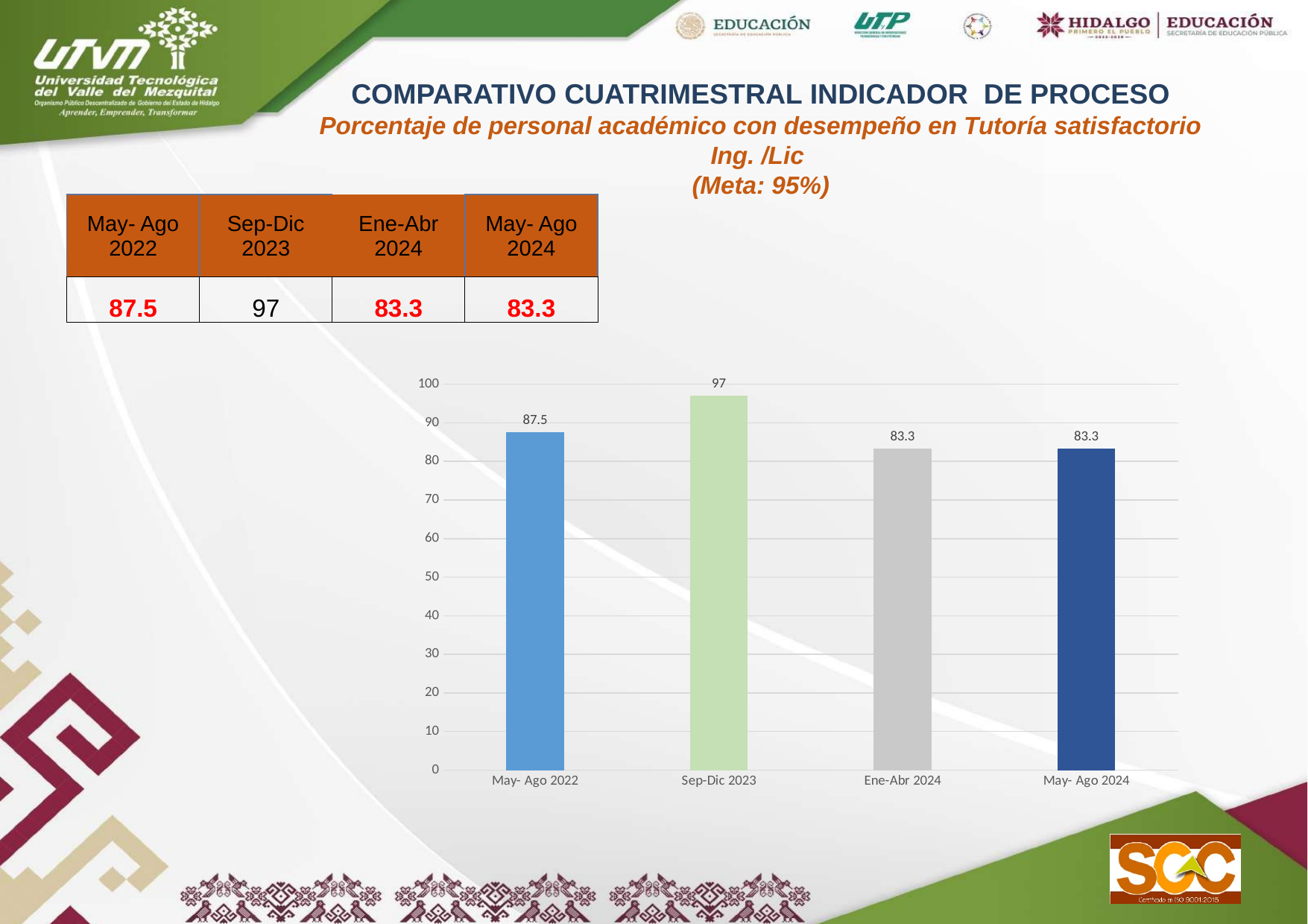
What is the value for May- Ago 2022? 87.5 What is the target (Meta) stated in the slide title? 95% What is the value for Ene-Abr 2024? 83.3 What is the difference between the values for Sep-Dic 2023 and May- Ago 2022? 9.5 What is the difference between the values for May- Ago 2022 and Ene-Abr 2024? 4.2 Is the value for Ene-Abr 2024 greater or less than 90? less Do the values rise or fall from Sep-Dic 2023 to Ene-Abr 2024? fall Which period has the highest value? Sep-Dic 2023 What is the value for Sep-Dic 2023? 97 What kind of chart is shown on the slide? bar chart Which is larger, the value for May- Ago 2022 or the value for May- Ago 2024? May- Ago 2022 How many periods are shown on the x axis of the chart? 4